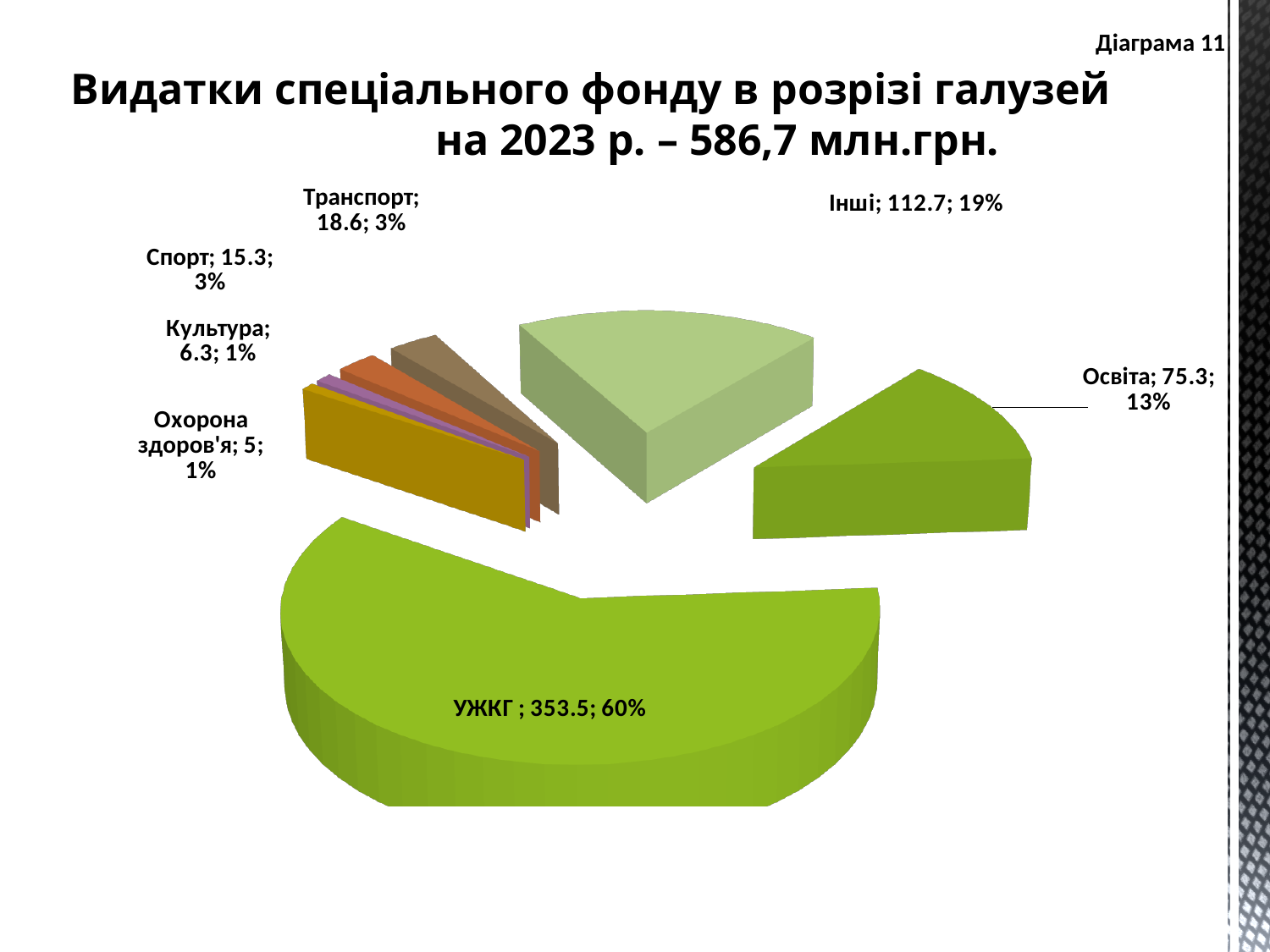
What kind of chart is shown on the slide? pie chart Which category has the smallest value? Охорона здоров'я What share of the pie does Освіта represent? 13% What share of the pie does УЖКГ represent? 60% What is the value for Культура? 6.3 What is the value for УЖКГ? 353.5 What is the difference between the values for Інші and Освіта? 37.4 Which is larger, the value for Транспорт or the value for Спорт? Транспорт What total amount is stated in the chart title for 2023? 586,7 млн.грн. What is the value for Інші? 112.7 Which category has the largest slice? УЖКГ How many categories are shown in the pie chart? 7